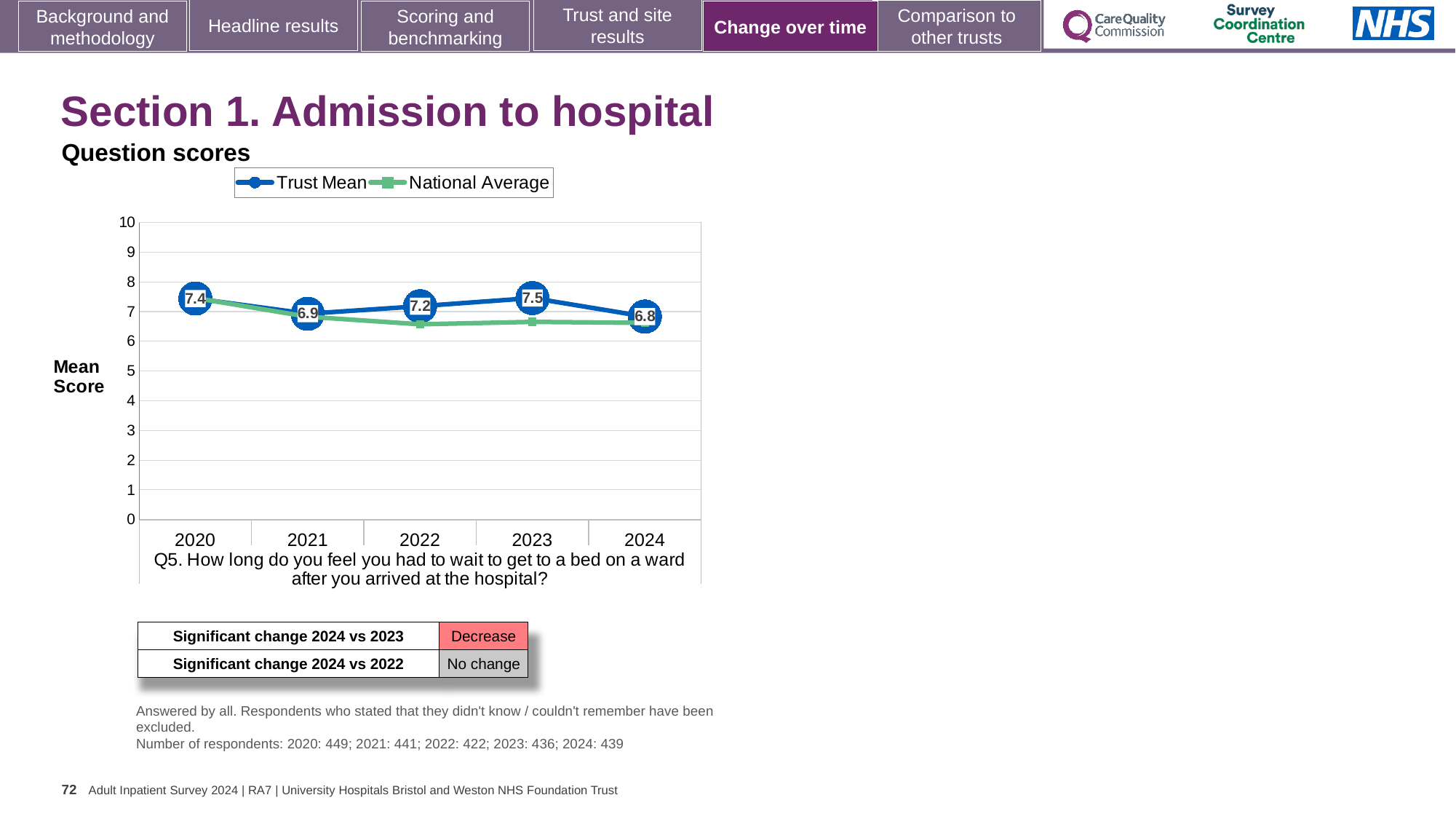
How many years are shown on the x axis? 5 In which year is the Trust Mean highest? 2023 In which year is the Trust Mean lowest? 2024 What is the difference between the Trust Mean in 2023 and in 2024? 0.7 What is the Trust Mean score for 2020? 7.4 Does the Trust Mean rise or fall from 2023 to 2024? fall How many series does the legend list? 2 What kind of chart is shown? line chart Which is larger in 2023, the Trust Mean or the National Average? Trust Mean What is the Trust Mean score for 2024? 6.8 Is the National Average value for 2022 greater or less than 7? less What is the Trust Mean score for 2023? 7.5